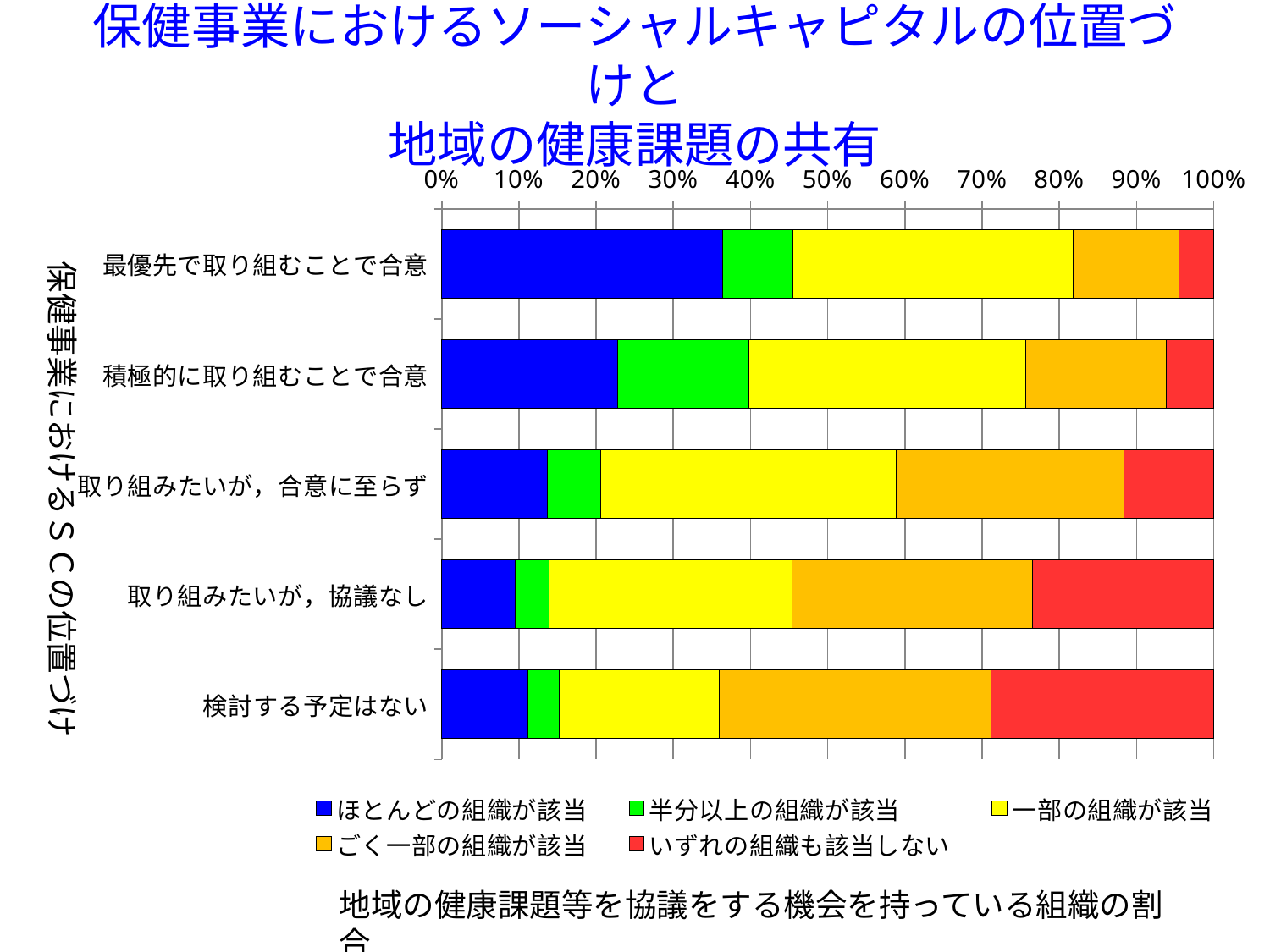
What kind of chart is shown on the slide? Stacked bar chart Which category has the largest red (いずれの組織も該当しない) segment? 検討する予定はない Is the blue (ほとんどの組織が該当) segment for 取り組みたいが，協議なし greater or less than 20%? less How many categories are plotted on the vertical axis of the chart? 5 Is the blue (ほとんどの組織が該当) segment for 最優先で取り組むことで合意 greater or less than 30%? greater Which has a larger blue (ほとんどの組織が該当) segment: 積極的に取り組むことで合意 or 取り組みたいが，合意に至らず? 積極的に取り組むことで合意 How many series does the legend list? 5 Which has a larger red (いずれの組織も該当しない) segment: 取り組みたいが，協議なし or 最優先で取り組むことで合意? 取り組みたいが，協議なし Which legend entry is shown in yellow? 一部の組織が該当 What is the label of the vertical axis of the chart? 保健事業におけるＳＣの位置づけ Moving from the top category (最優先で取り組むことで合意) down to 取り組みたいが，協議なし, does the blue (ほとんどの組織が該当) segment rise or fall? fall Which category has the largest blue (ほとんどの組織が該当) segment? 最優先で取り組むことで合意